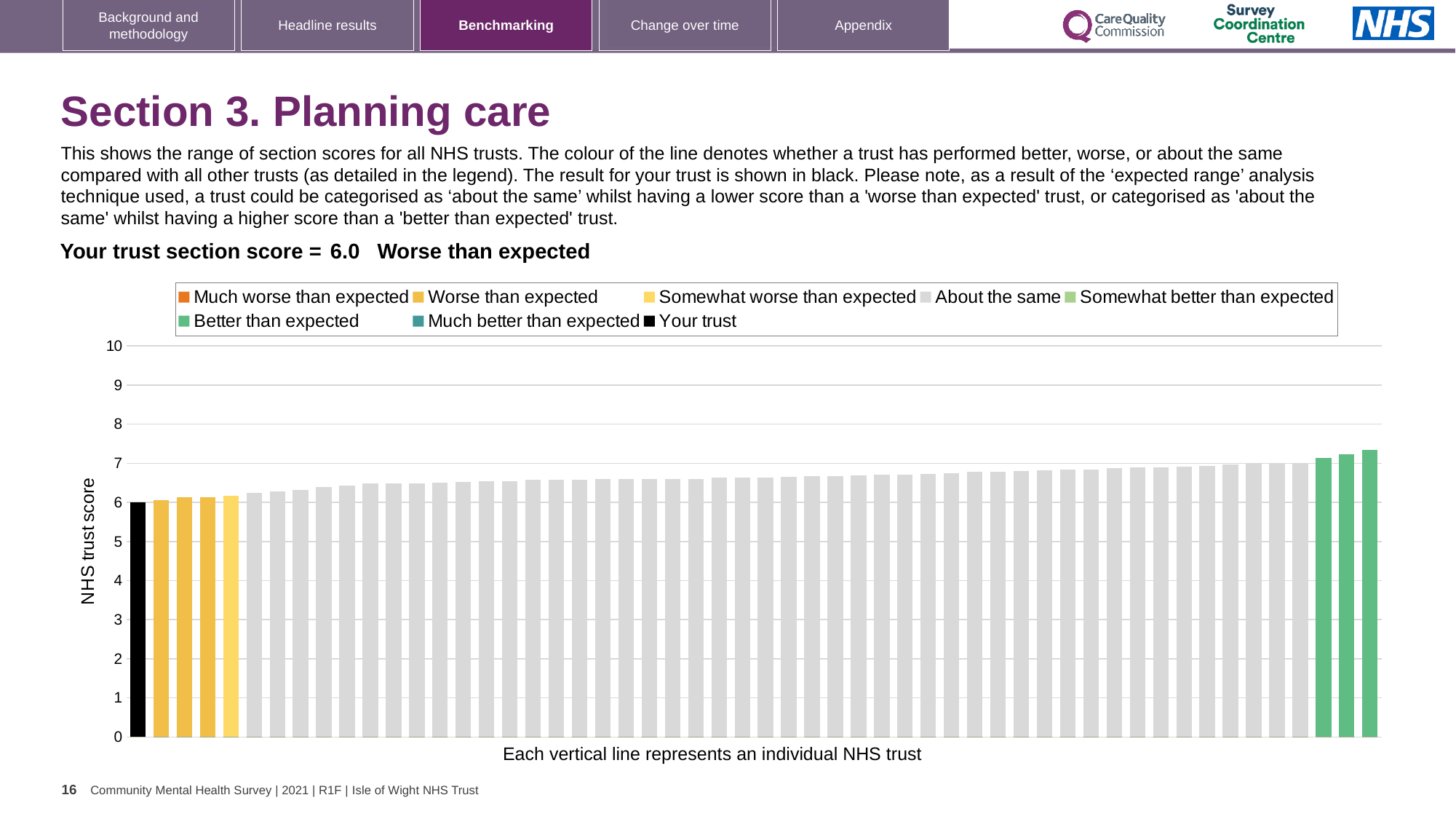
What is the label on the vertical axis of the chart? NHS trust score How many entries does the chart legend list? 8 How many green bars (better than expected) are shown in the chart? 3 Which is larger: the black bar for your trust or the rightmost bar? the rightmost bar What does the text below the chart say each vertical line represents? an individual NHS trust Which benchmarking category is your trust's section score placed in? Worse than expected What kind of chart is shown on the slide? bar chart Is the value of the tallest (rightmost) bar greater or less than 7? greater What is the section score for your trust shown on the slide? 6.0 Which bar in the chart has the lowest value? Your trust (the black bar) Is the value of the black bar (your trust) greater or less than 7? less Do the bar values rise or fall from left to right along the x axis? rise